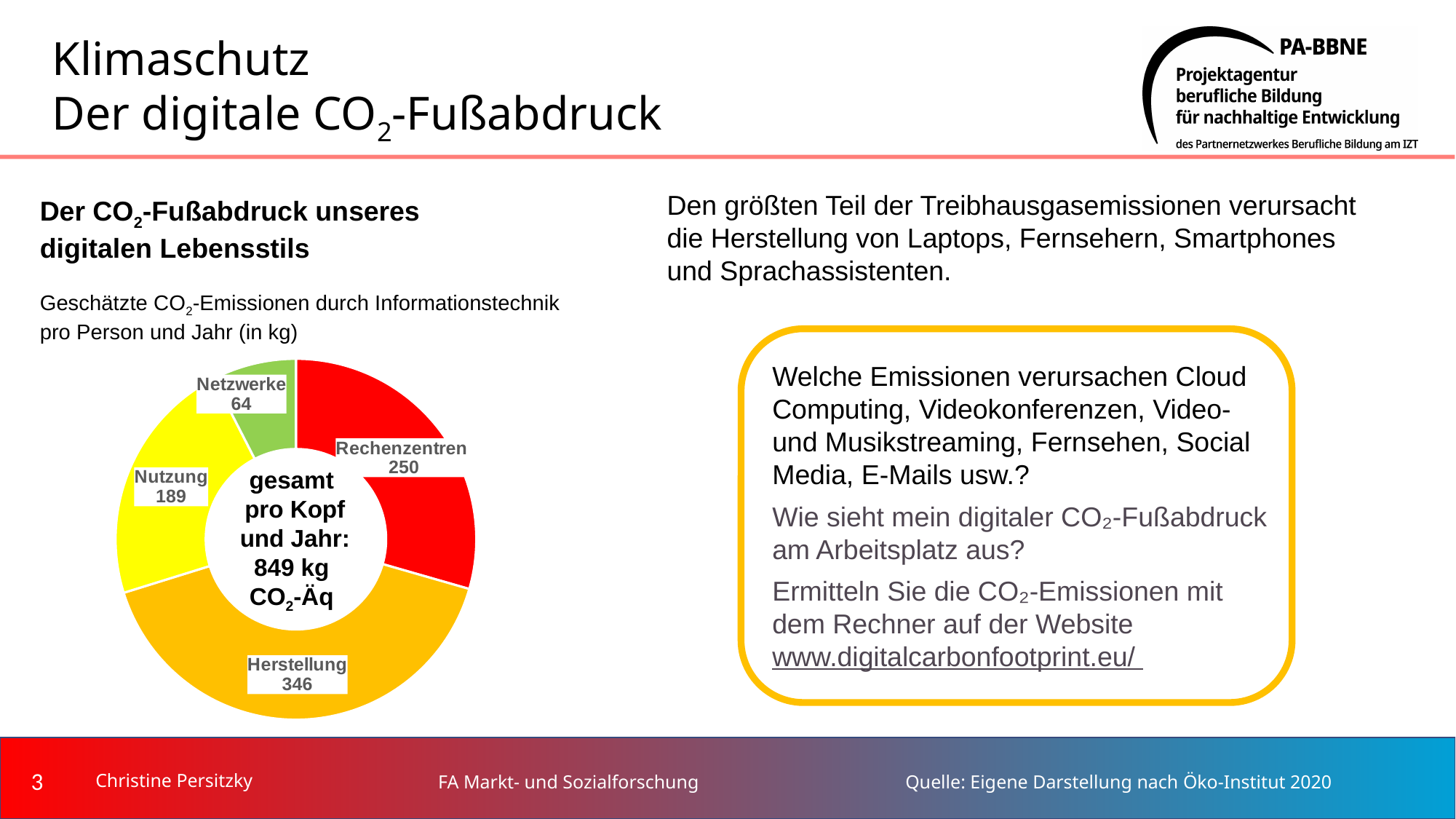
What is the difference between the values for Herstellung and Rechenzentren? 96 What total per person and year is stated in the centre of the chart? 849 kg CO2-Äq What value is shown for Rechenzentren in the chart? 250 Which category has the largest share of the CO2 emissions in the chart? Herstellung What value is shown for Herstellung in the doughnut chart? 346 Which category has the smallest share in the chart? Netzwerke What value is shown for Netzwerke in the chart? 64 Which is larger, the value for Rechenzentren or the value for Nutzung? Rechenzentren What is the difference between the values for Nutzung and Netzwerke? 125 What value is shown for Nutzung in the chart? 189 How many categories does the doughnut chart show? 4 What kind of chart is used on the slide? doughnut (pie) chart